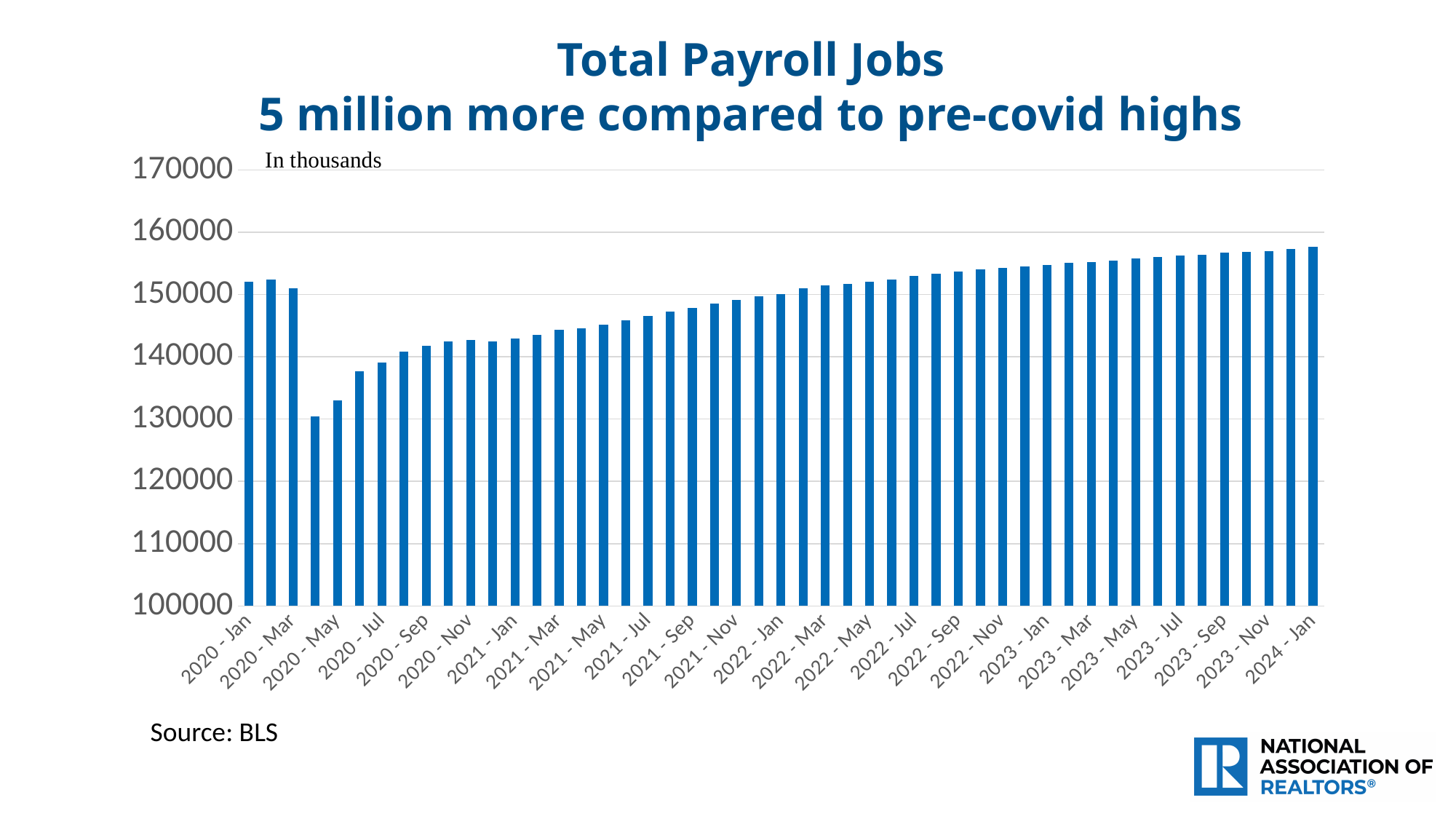
Which month has the highest value on the chart? 2024 - Jan Is the value for 2020 - Jan greater or less than 150000? greater What kind of chart is shown on the slide? bar chart In what units are the values on the chart expressed? In thousands Is the value for 2024 - Jan greater or less than 160000? less Which is larger, the value for 2020 - May or the value for 2020 - Jul? 2020 - Jul Is the value for 2023 - Jan greater or less than 150000? greater Which is larger, the value for 2024 - Jan or the value for 2020 - Jan? 2024 - Jan Do the values rise or fall from 2020 - May to 2024 - Jan? rise What is the source of the data shown on the chart? BLS